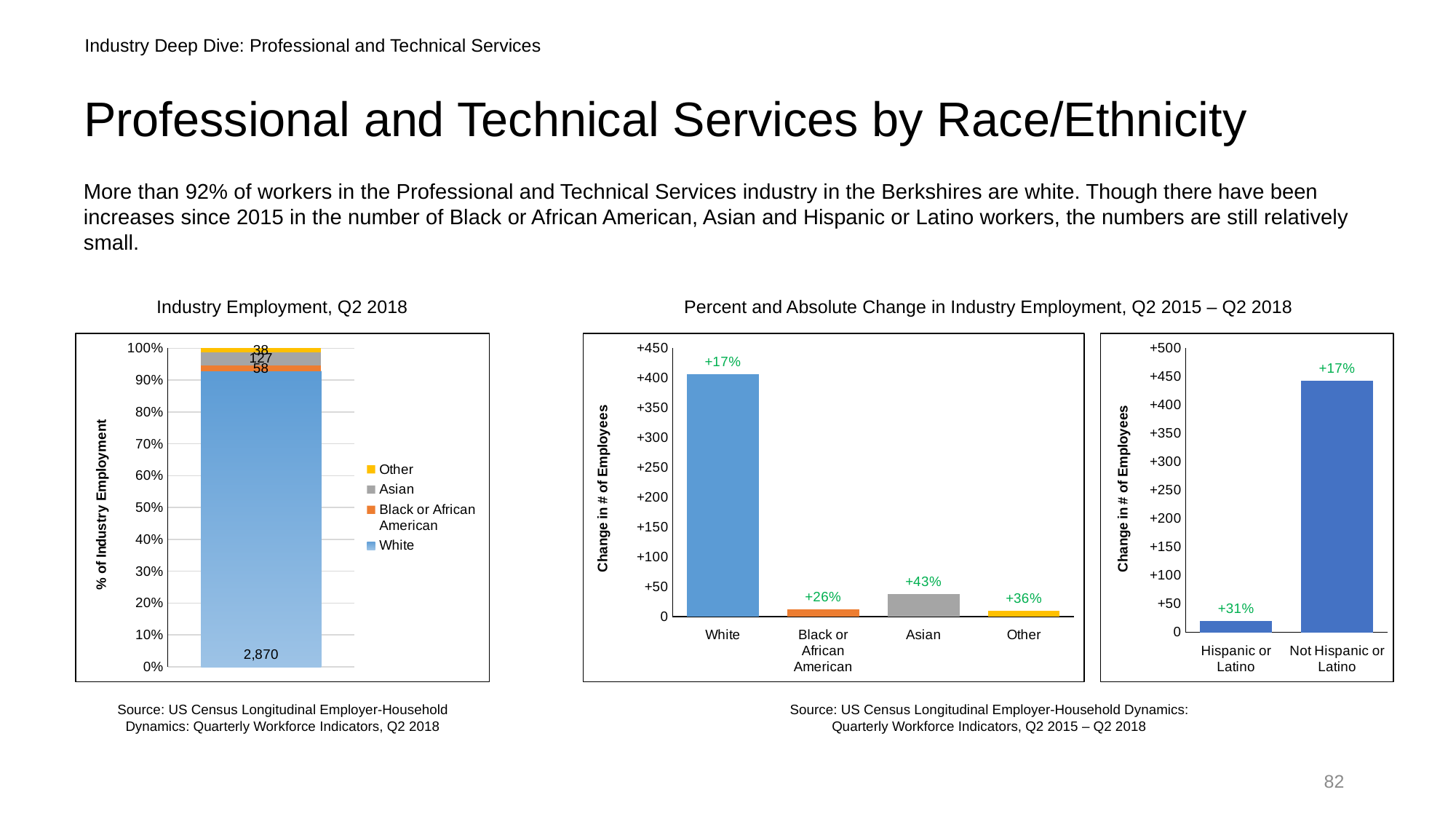
In the middle chart of percent and absolute change by race, how many categories are shown on the x axis? 4 In the right-hand chart by Hispanic or Latino status, is the change in number of employees for Not Hispanic or Latino greater or less than 400? greater In the 'Industry Employment, Q2 2018' chart, what is the number of Black or African American workers shown on the bar? 58 In the middle chart of percent and absolute change by race, what is the percent change label for Black or African American? +26% In the middle chart of percent and absolute change by race, is the change in number of employees for White greater or less than 350? greater In the 'Industry Employment, Q2 2018' chart, what is the difference between the number of Asian workers and the number of Other workers? 89 In the 'Industry Employment, Q2 2018' chart, what is the number of White workers shown on the bar? 2,870 In the 'Industry Employment, Q2 2018' chart, what is the number of Asian workers shown on the bar? 127 In the right-hand chart by Hispanic or Latino status, what is the percent change label for Hispanic or Latino? +31% In the middle chart of percent and absolute change by race, what is the percent change label for Asian? +43% In the middle chart of percent and absolute change by race, which category has the largest absolute change in number of employees? White In the 'Industry Employment, Q2 2018' chart, how many series does the legend list? 4